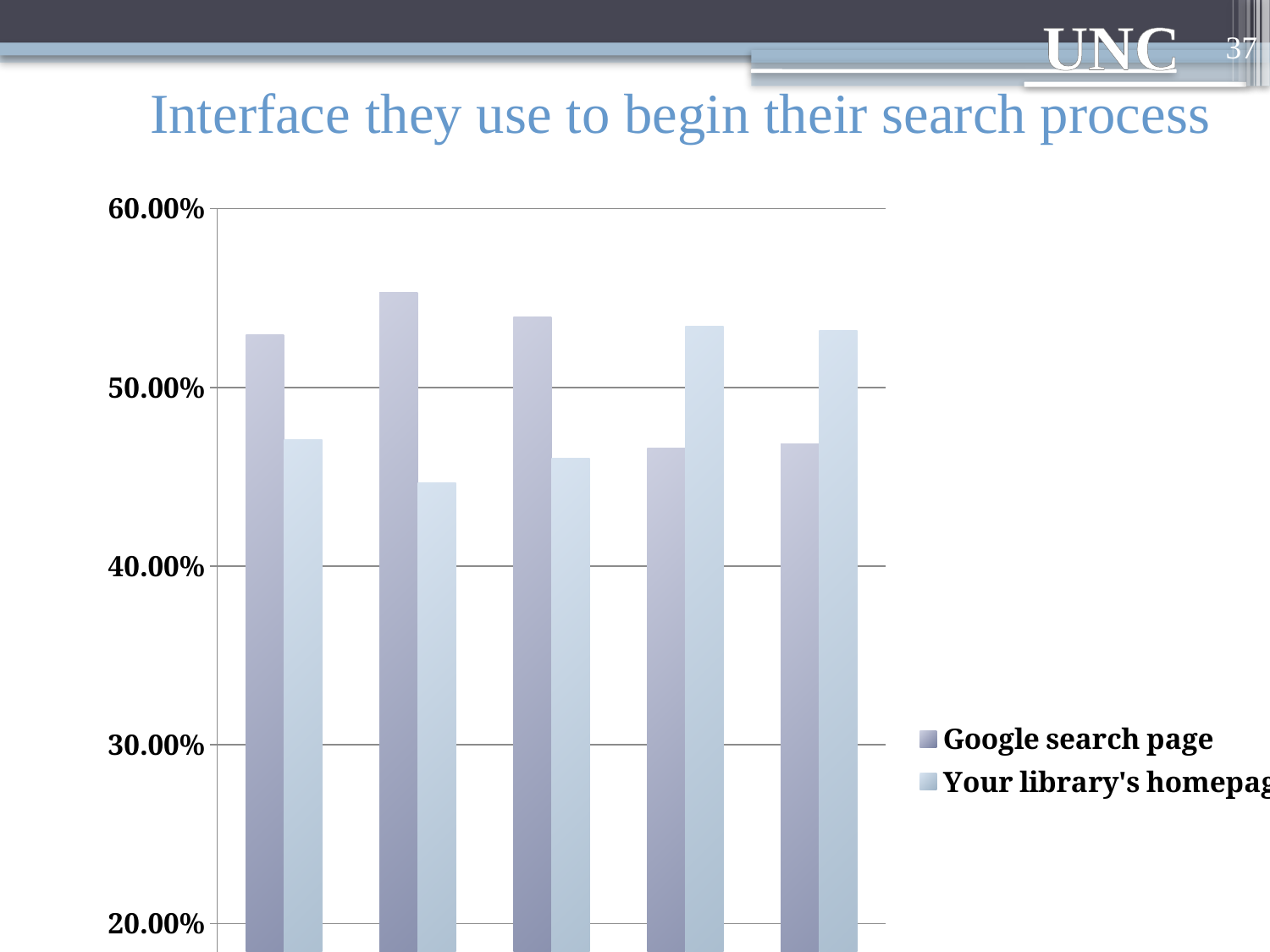
In the fourth group of bars from the left, which series has the larger value, Google search page or Your library's homepage? Your library's homepage Are any of the bars in the chart above 60.00%? No What is the title of the slide's chart? Interface they use to begin their search process In the first group of bars from the left, is the value for Google search page greater or less than 50.00%? greater In the second group of bars from the left, is the value for Your library's homepage greater or less than 40.00%? greater Which series is listed first in the legend? Google search page How many groups of bars are plotted in the chart? 5 What kind of chart is shown on the slide? bar chart In the second group of bars from the left, which series has the larger value, Google search page or Your library's homepage? Google search page How many series does the legend list? 2